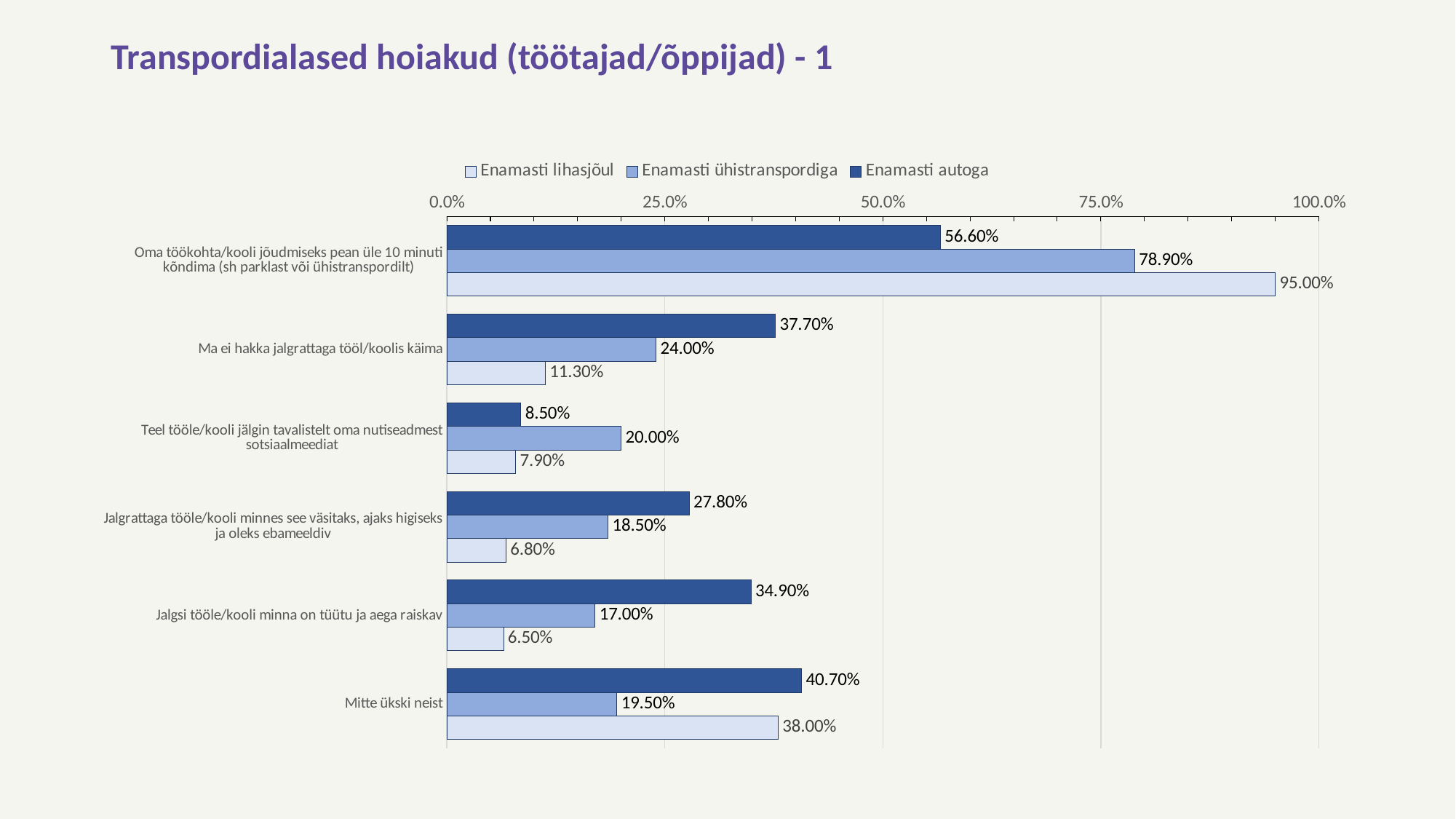
In the category 'Teel tööle/kooli jälgin tavalistelt oma nutiseadmest sotsiaalmeediat', which series has the larger value: 'Enamasti autoga' or 'Enamasti ühistranspordiga'? Enamasti ühistranspordiga What is the difference between the 'Enamasti ühistranspordiga' and 'Enamasti autoga' values in the category 'Oma töökohta/kooli jõudmiseks pean üle 10 minuti kõndima (sh parklast või ühistranspordilt)'? 22.30% What is the title of the slide? Transpordialased hoiakud (töötajad/õppijad) - 1 What kind of chart is shown on the slide? Bar chart Which category has the highest value for 'Enamasti autoga'? Oma töökohta/kooli jõudmiseks pean üle 10 minuti kõndima (sh parklast või ühistranspordilt) Which category has the lowest value for 'Enamasti lihasjõul'? Jalgsi tööle/kooli minna on tüütu ja aega raiskav What is the value for 'Enamasti ühistranspordiga' in the category 'Mitte ükski neist'? 19.50% What is the value for 'Enamasti lihasjõul' in the category 'Oma töökohta/kooli jõudmiseks pean üle 10 minuti kõndima (sh parklast või ühistranspordilt)'? 95.00% How many categories are shown on the chart? 6 What is the value for 'Enamasti autoga' in the category 'Ma ei hakka jalgrattaga tööl/koolis käima'? 37.70% Is the value for 'Enamasti autoga' in the category 'Mitte ükski neist' greater or less than 50.0%? less How many series does the legend list? 3